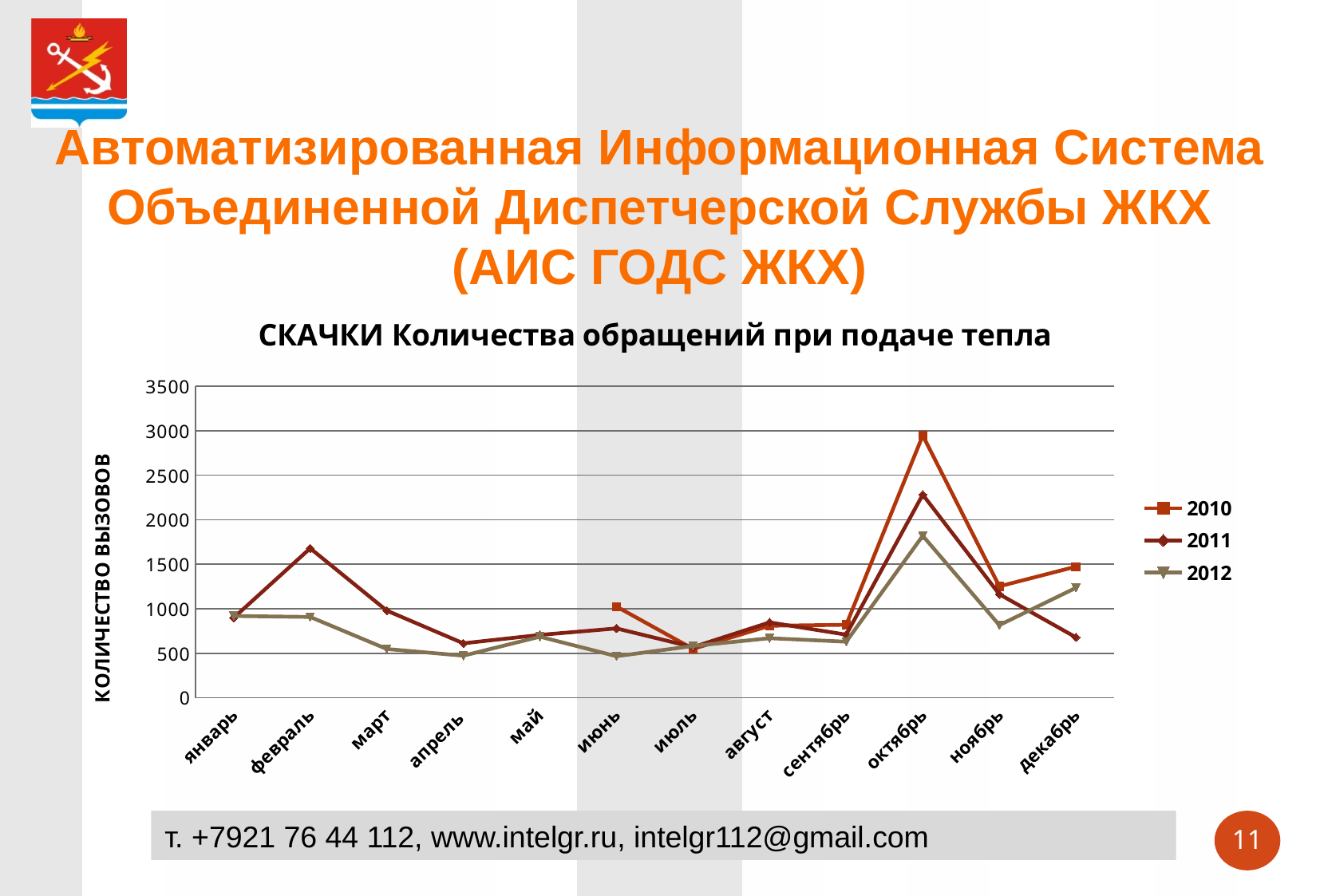
In which month does the 2010 series reach its highest value? октябрь Does the 2011 series rise or fall from октябрь to декабрь? fall How many months are shown along the x axis? 12 Is the value for 2011 in февраль greater or less than 1500? greater How many series does the legend list? 3 Is the value for 2012 in октябрь greater or less than 2000? less Is the value for 2010 in октябрь greater or less than 2500? greater What kind of chart is shown on the slide? line chart In which month does the 2011 series reach its highest value? октябрь Which series has the larger value in февраль, 2011 or 2012? 2011 What is the title of the chart? СКАЧКИ Количества обращений при подаче тепла Which series has the larger value in октябрь, 2010 or 2011? 2010